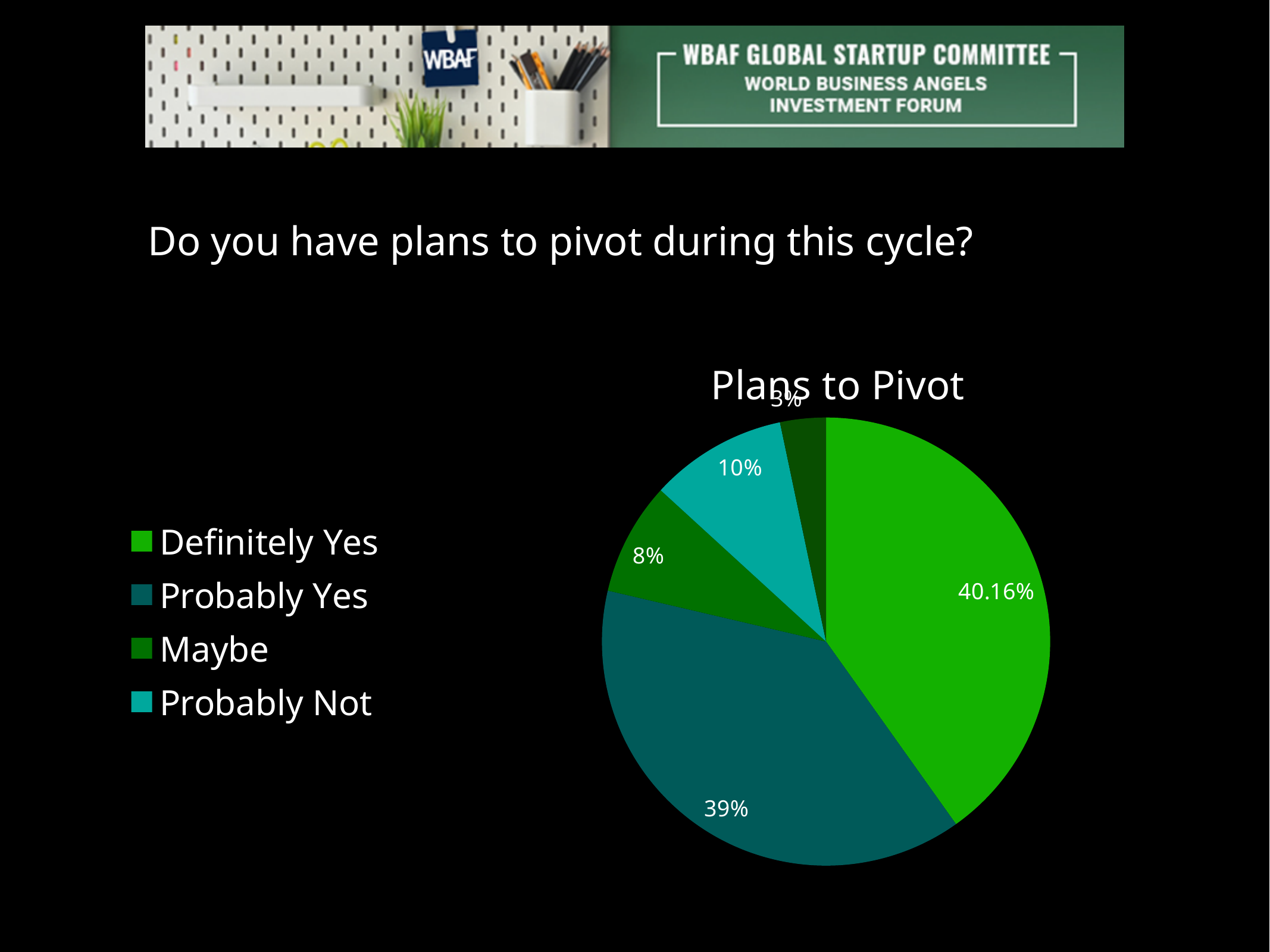
Of the four categories listed in the legend, which has the smallest share in the Plans to Pivot chart? Maybe What share does the "Probably Yes" slice have in the Plans to Pivot pie chart? 39% What is the value shown for "Maybe" in the Plans to Pivot chart? 8% Which category has the largest slice in the Plans to Pivot pie chart? Definitely Yes What is the value shown for "Probably Not" in the Plans to Pivot chart? 10% What percentage of respondents answered "Definitely Yes" in the Plans to Pivot chart? 40.16% Which is larger in the Plans to Pivot chart, "Probably Not" or "Maybe"? Probably Not How many entries does the legend of the Plans to Pivot chart list? 4 What is the difference between the "Probably Not" and "Maybe" shares in the Plans to Pivot chart? 2% What is the title of the pie chart on the slide? Plans to Pivot What type of chart is used to show Plans to Pivot? Pie chart